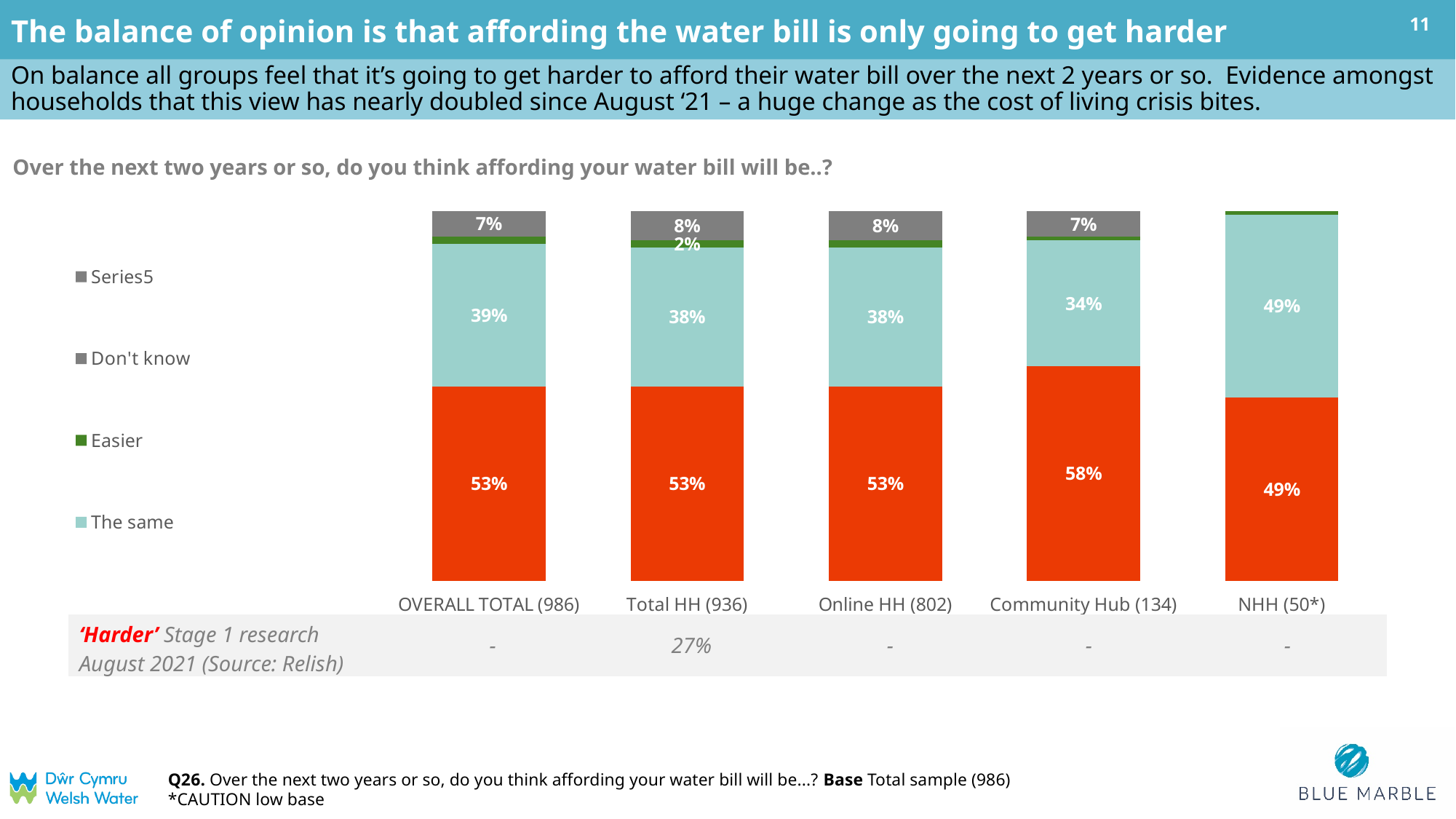
Which category has the lowest value for the bottom red segment? NHH (50*) What type of chart is shown on the slide? Stacked bar chart What is the value of 'The same' segment for NHH (50*)? 49% Which is larger, 'The same' for OVERALL TOTAL (986) or 'The same' for Community Hub (134)? OVERALL TOTAL (986) How many categories are shown on the x axis of the chart? 5 What is the difference between the bottom red segment for Community Hub (134) and for OVERALL TOTAL (986)? 5 percentage points What is the 'Easier' value for Total HH (936)? 2% What is the 'Harder' Stage 1 research August 2021 value shown for Total HH (936) in the row below the chart? 27% How many series does the chart legend list? 4 What is the value of the bottom red segment for Community Hub (134)? 58% What is the 'Don't know' value for Total HH (936)? 8% Which category has the highest value for the bottom red segment? Community Hub (134)